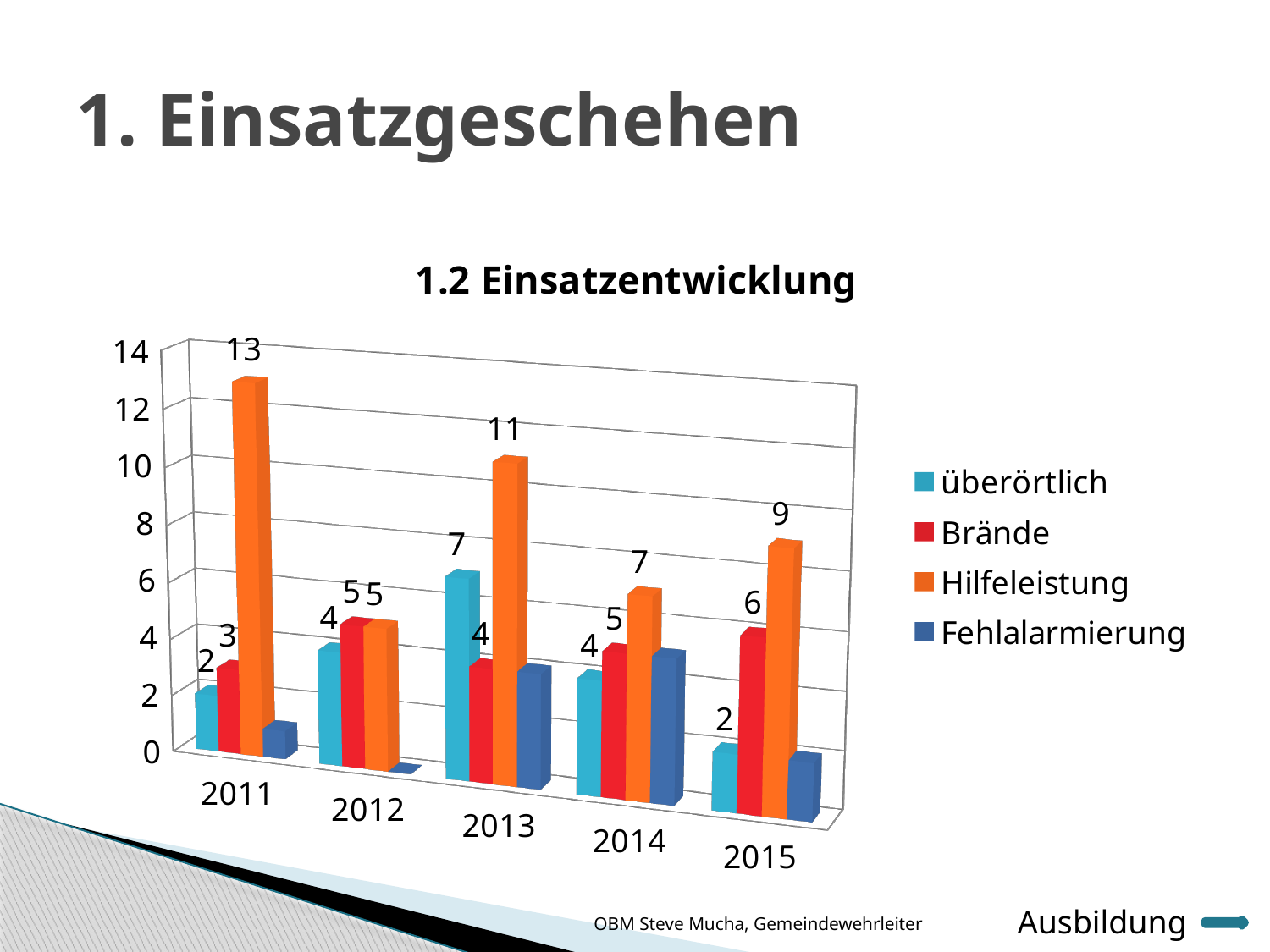
In which year is the überörtlich value lowest? 2011 and 2015 In 2013, which is larger: überörtlich or Brände? überörtlich What is the value for überörtlich in 2013? 7 What is the value for Hilfeleistung in 2011? 13 What kind of chart is shown? bar chart How many years are shown on the x axis? 5 Does the Hilfeleistung value rise or fall from 2013 to 2014? fall In which year is the Hilfeleistung value highest? 2011 How many series does the legend list? 4 What is the difference between the Hilfeleistung values for 2011 and 2013? 2 Is the value for Fehlalarmierung in 2013 greater or less than 6? less What is the value for Brände in 2015? 6